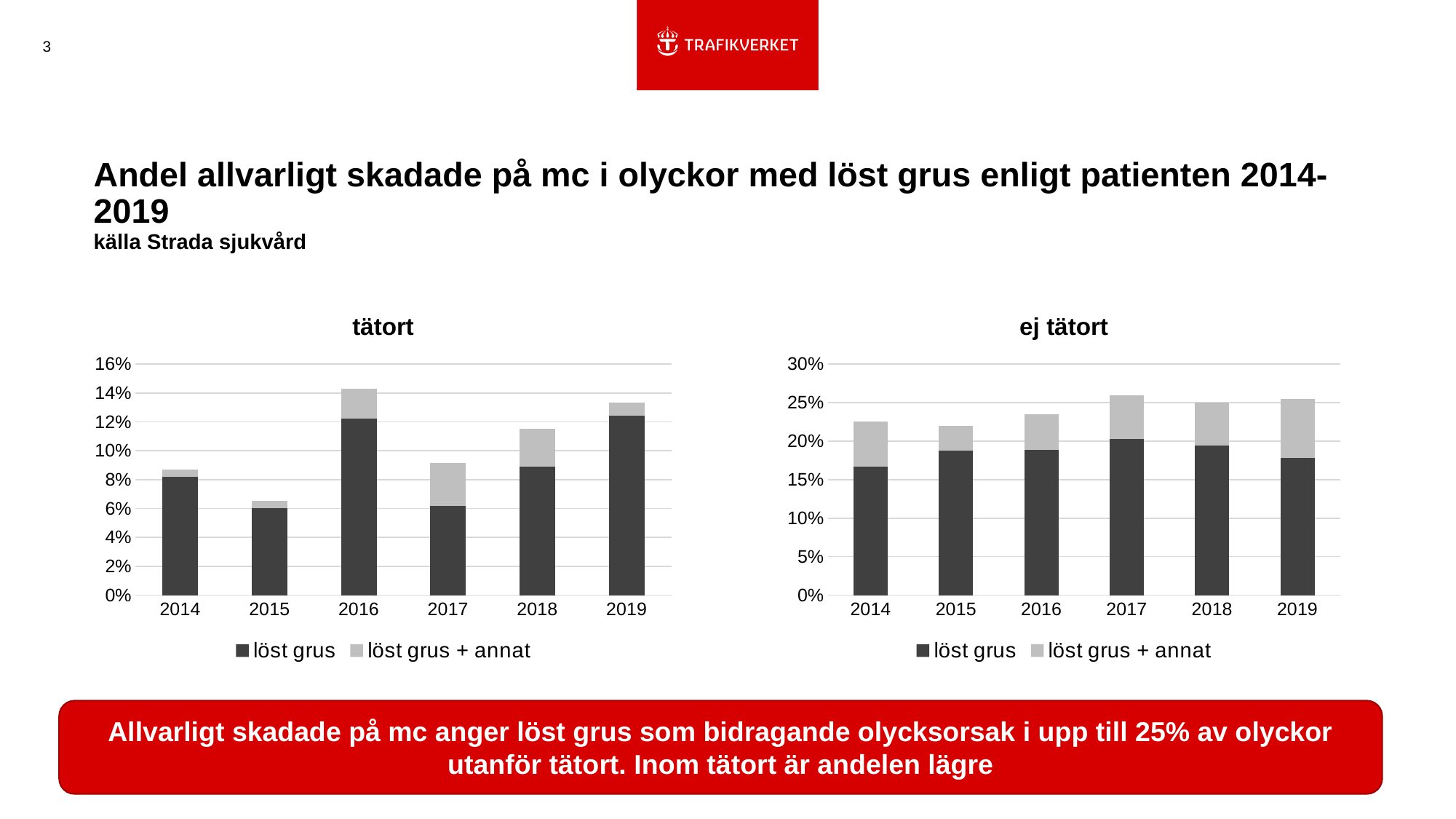
In the 'tätort' chart, which is larger: the total stacked bar for 2018 or for 2017? 2018 In the 'tätort' chart, is the total stacked value for 2016 greater or less than 12%? greater How many series does the legend of the 'tätort' chart list? 2 In the 'ej tätort' chart, is the 'löst grus' value for 2014 greater or less than 20%? less In the 'tätort' chart, which year has the lowest total stacked bar? 2015 What type of chart is the 'tätort' chart? stacked bar chart In the 'tätort' chart, is the total stacked value for 2015 greater or less than 8%? less In the 'ej tätort' chart, which year has the highest 'löst grus' value? 2017 How many years are shown on the x axis of the 'ej tätort' chart? 6 In the 'tätort' chart, which year has the highest total stacked bar? 2016 In the 'ej tätort' chart, which year has the lowest 'löst grus' value? 2014 What are the two legend entries in the 'ej tätort' chart? löst grus; löst grus + annat